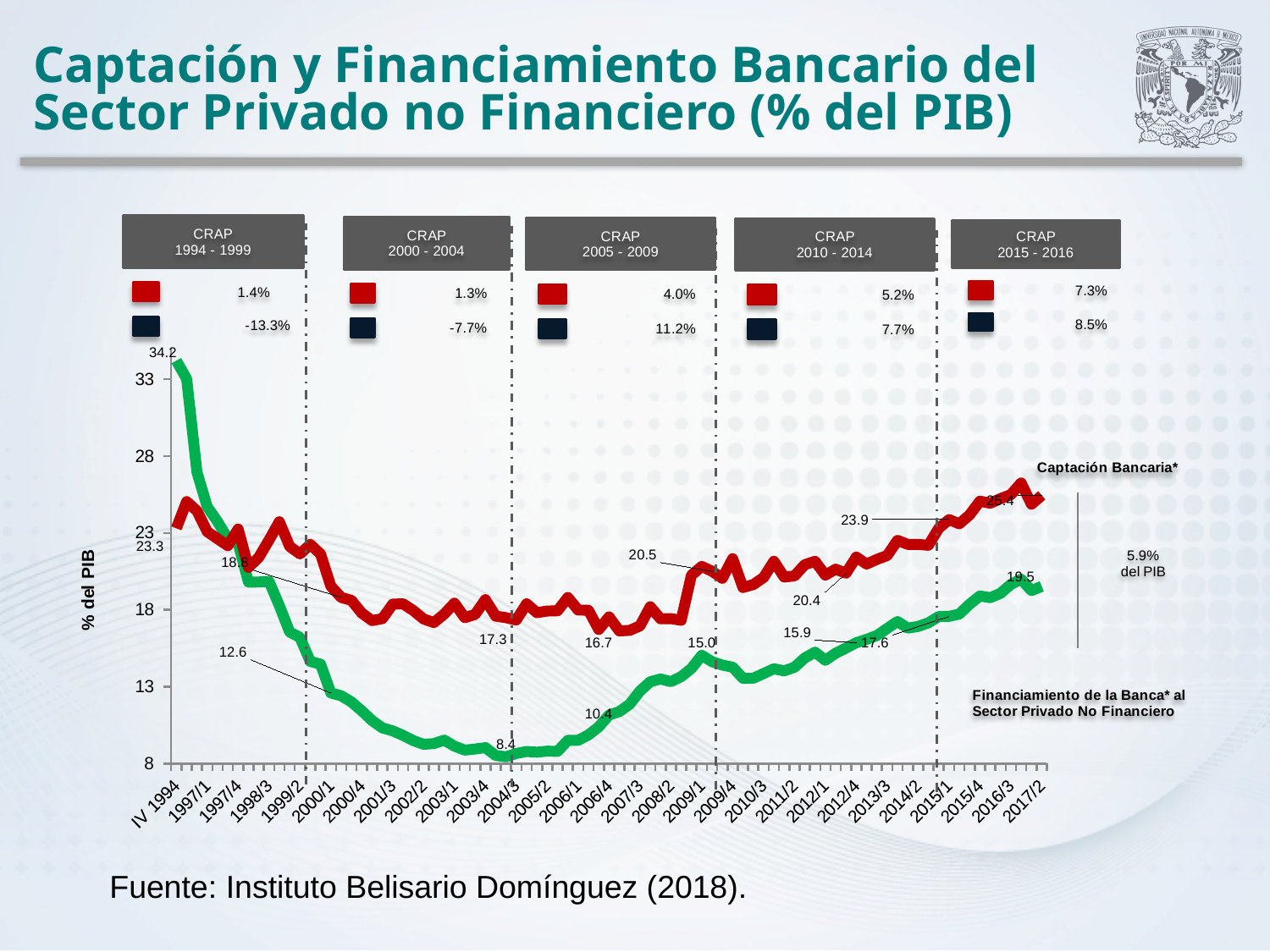
What is the difference between the Financiamiento de la Banca value (34.2) and the Captación Bancaria value (23.3) at IV 1994? 10.9 Which series is higher at 2017/2, Captación Bancaria or Financiamiento de la Banca? Captación Bancaria What is the lowest labelled value on the Financiamiento de la Banca line? 8.4 What is the last labelled value of the Captación Bancaria line, at 2017/2? 25.4 What is the difference between the Captación Bancaria value (25.4) and the Financiamiento de la Banca value (19.5) at 2017/2? 5.9 What is the red-box percentage shown for the CRAP 2005 - 2009 period? 4.0% What kind of chart is shown on the slide? Line chart What is the last labelled value of the Financiamiento de la Banca line, at 2017/2? 19.5 Does the Financiamiento de la Banca line rise or fall from IV 1994 to 2004/3? Fall What is the value of the Captación Bancaria line at IV 1994? 23.3 How many CRAP periods are marked above the chart? 5 What is the value of the Financiamiento de la Banca al Sector Privado No Financiero line at IV 1994? 34.2